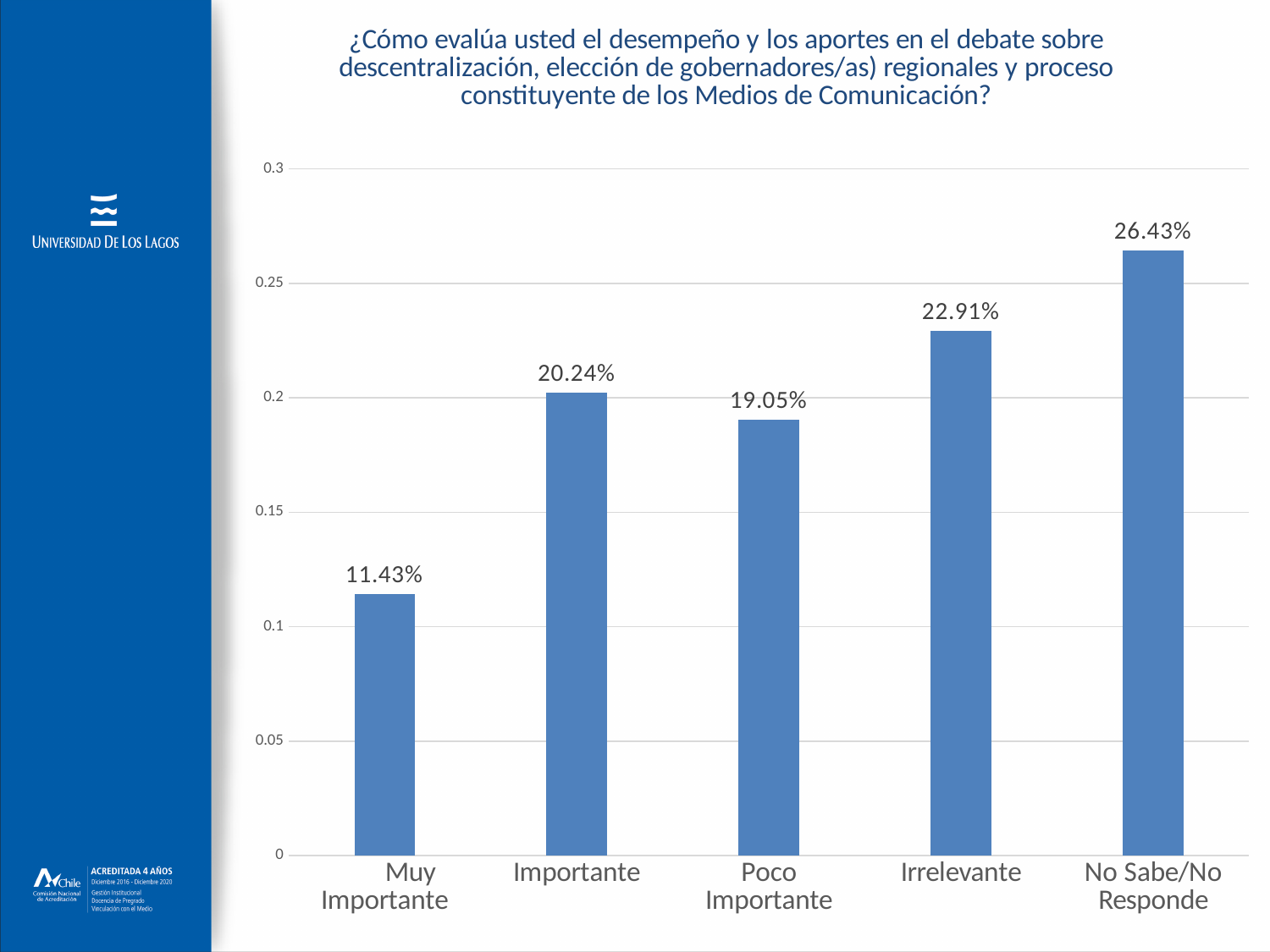
How many categories are shown on the x axis? 5 Which is larger, the value for Importante or the value for Poco Importante? Importante Is the value for Irrelevante greater or less than 0.2? greater What is the value for Poco Importante? 19.05% What kind of chart is shown on the slide? bar chart What is the difference between the values for No Sabe/No Responde and Muy Importante? 15.00% What is the value for Muy Importante? 11.43% Which category has the highest value? No Sabe/No Responde Which category has the lowest value? Muy Importante What is the value for No Sabe/No Responde? 26.43% What is the value for Importante? 20.24% What is the value for Irrelevante? 22.91%